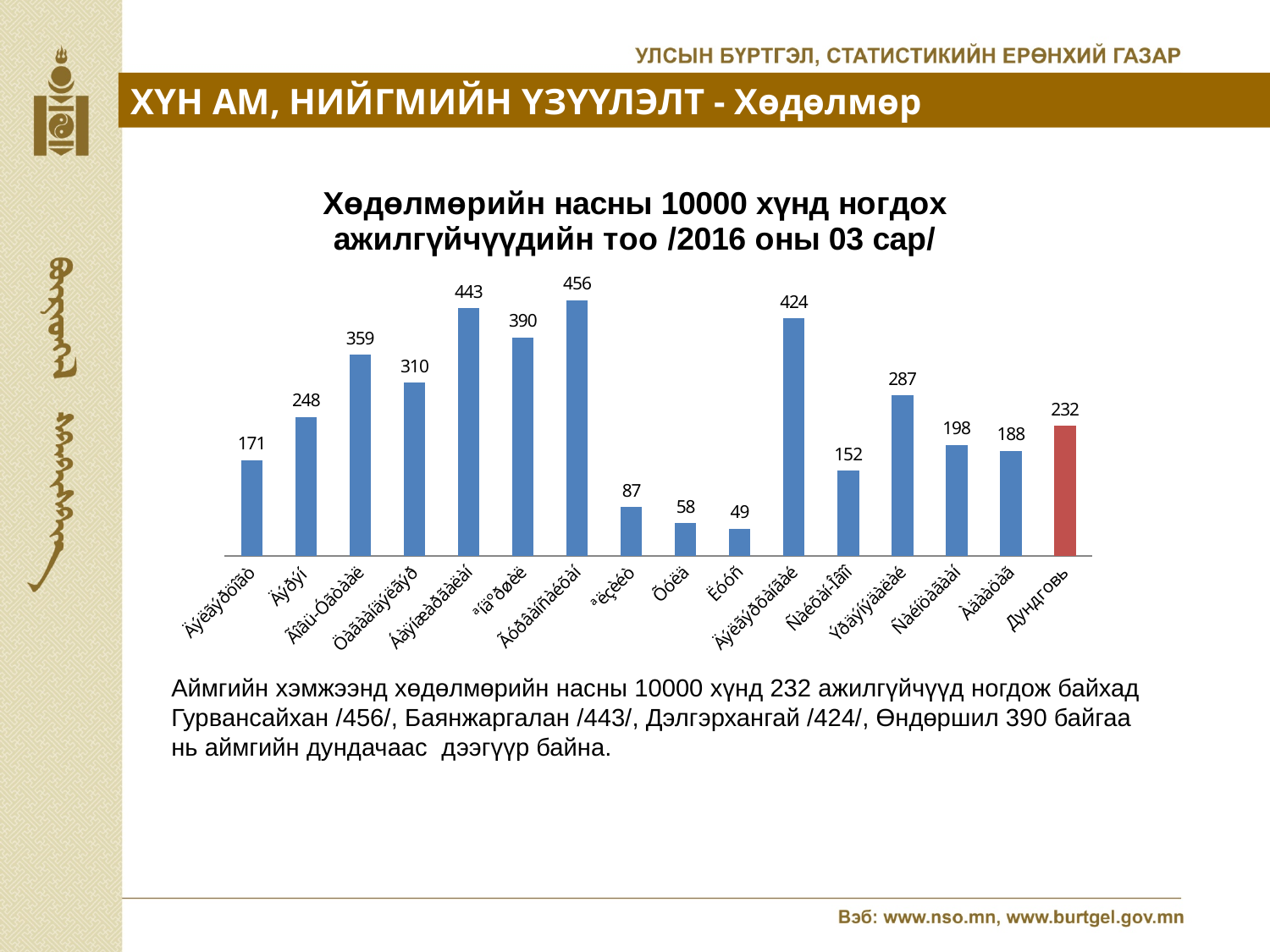
What is the difference between the highest value (456) and the lowest value (49) in the chart? 407 What colour is the bar for Дундговь? red What is the lowest value plotted in the chart? 49 What is the highest value plotted in the chart? 456 What is the value shown for Дундговь? 232 What kind of chart is shown on the slide? bar chart What is the difference between the highest value in the chart (456) and the value for Дундговь? 224 How many bars in the chart have a value above 400? 3 Is the value for Дундговь greater or less than 200? greater How many bars in the chart have a value below 100? 3 What is the title of the chart? Хөдөлмөрийн насны 10000 хүнд ногдох ажилгүйчүүдийн тоо /2016 оны 03 сар/ How many bars does the chart contain? 16